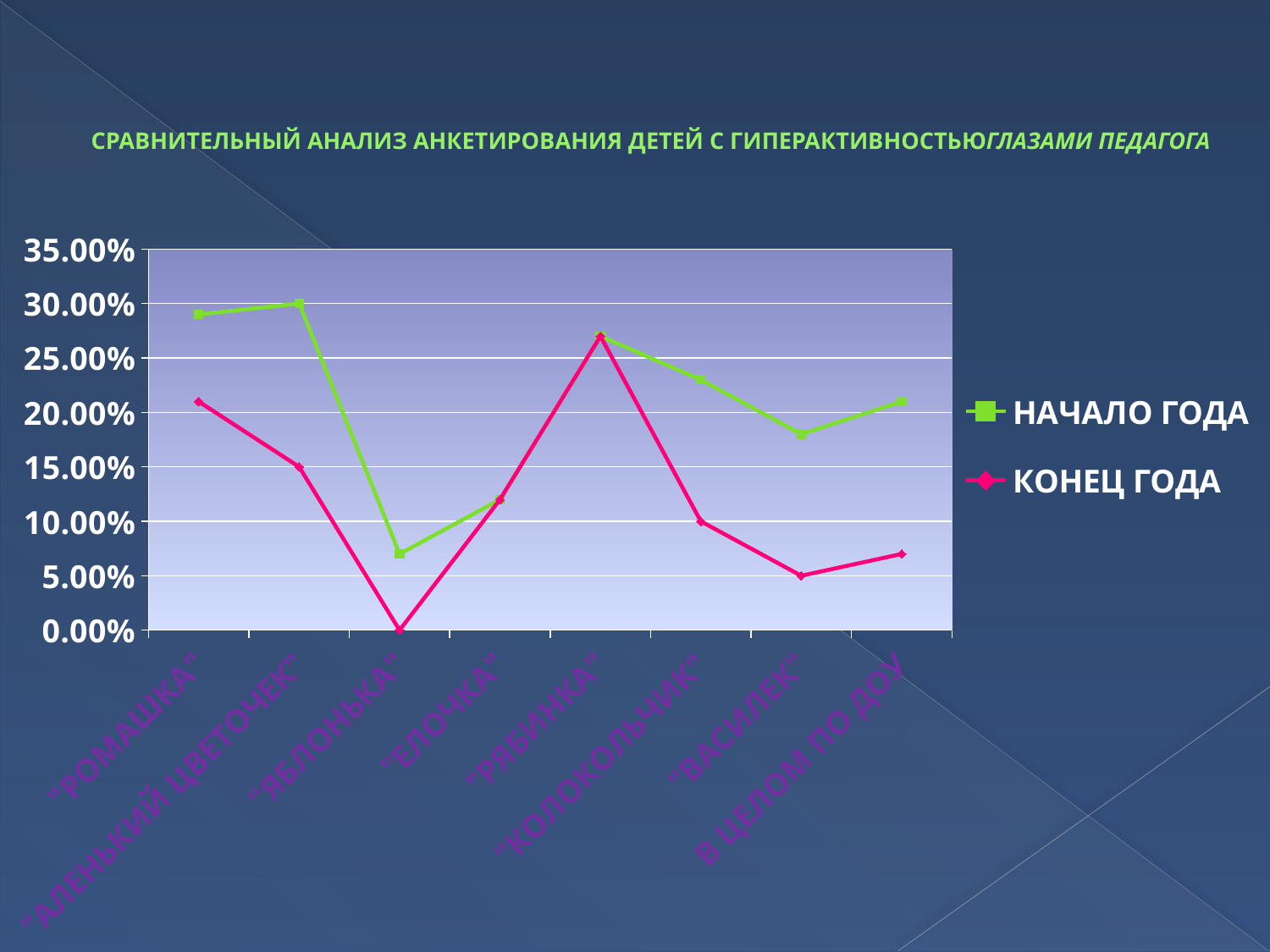
What is the value for "КОЛОКОЛЬЧИК" in the КОНЕЦ ГОДА series? 10.00% Which colour is used for the КОНЕЦ ГОДА series? pink What is the value for "ЯБЛОНЬКА" in the КОНЕЦ ГОДА series? 0.00% How many categories are plotted along the x axis? 8 Is the КОНЕЦ ГОДА value for "В ЦЕЛОМ ПО ДОУ" greater or less than 10.00%? less How many series does the legend list? 2 What kind of chart is shown on the slide? line chart Is the НАЧАЛО ГОДА value for "РОМАШКА" greater or less than 25.00%? greater For "РОМАШКА", which series has the larger value, НАЧАЛО ГОДА or КОНЕЦ ГОДА? НАЧАЛО ГОДА Which category has the lowest value in the НАЧАЛО ГОДА series? "ЯБЛОНЬКА" Which category has the highest value in the КОНЕЦ ГОДА series? "РЯБИНКА" What is the value for "ВАСИЛЕК" in the КОНЕЦ ГОДА series? 5.00%